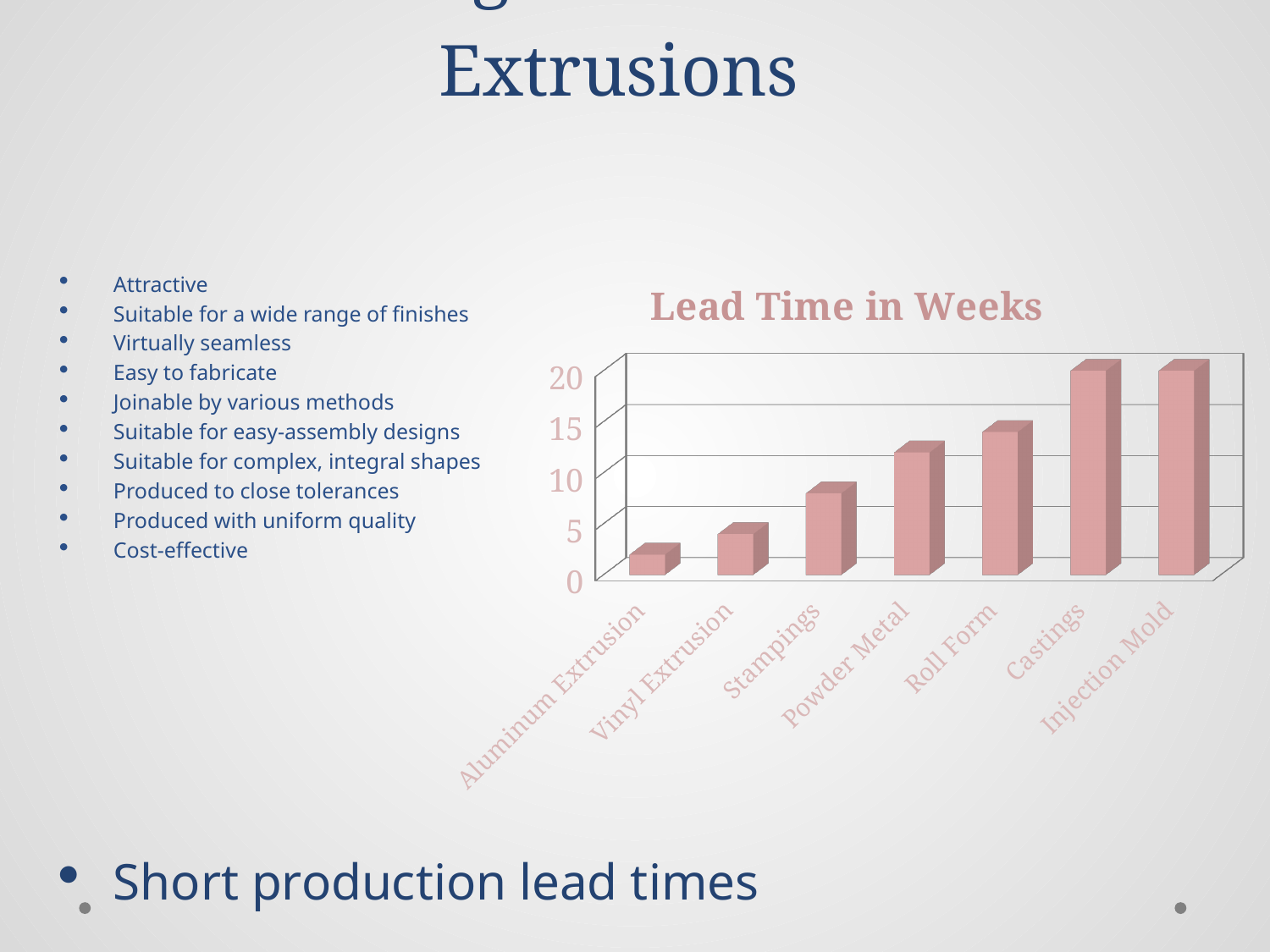
How many categories are shown on the x axis of the chart? 7 Do the values rise or fall moving from left to right along the x axis? rise Which category has the lowest lead time in the chart? Aluminum Extrusion Which category is the first one on the left of the x axis? Aluminum Extrusion Is the value for Powder Metal greater or less than 10? greater What is the title of the chart? Lead Time in Weeks Which has a longer lead time, Roll Form or Powder Metal? Roll Form Is the value for Castings greater or less than 15? greater What kind of chart is shown on the slide? bar chart Is the value for Stampings greater or less than 10? less Which has a longer lead time, Stampings or Vinyl Extrusion? Stampings